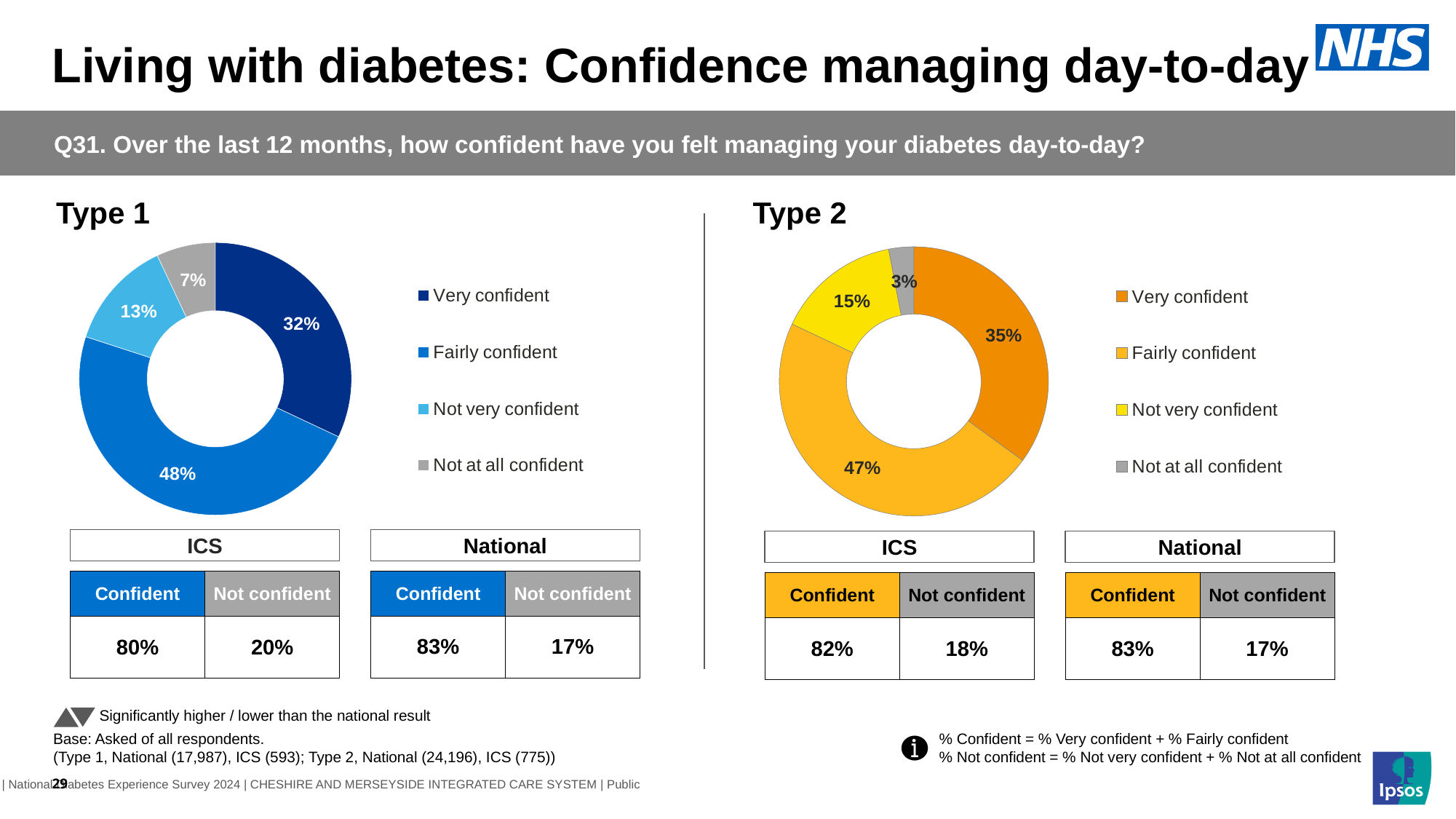
In the Type 1 chart, which category has the largest share? Fairly confident How many categories does the Type 1 chart's legend list? 4 What kind of chart is used for Type 2? Doughnut (pie) chart In the Type 1 chart, what percentage of respondents were Not at all confident? 7% In the Type 2 chart, what percentage of respondents were Not very confident? 15% In the Type 1 chart, what is the difference between the Fairly confident and Very confident shares? 16 percentage points In the Type 2 chart, which is larger: Very confident or Not very confident? Very confident In the Type 2 chart, what percentage of respondents were Fairly confident? 47% In the Type 1 chart, what is the combined share of Not very confident and Not at all confident? 20% In the Type 2 chart, what colour represents Fairly confident? Yellow-orange In the Type 2 chart, which category has the smallest share? Not at all confident In the Type 1 chart, what percentage of respondents were Very confident? 32%